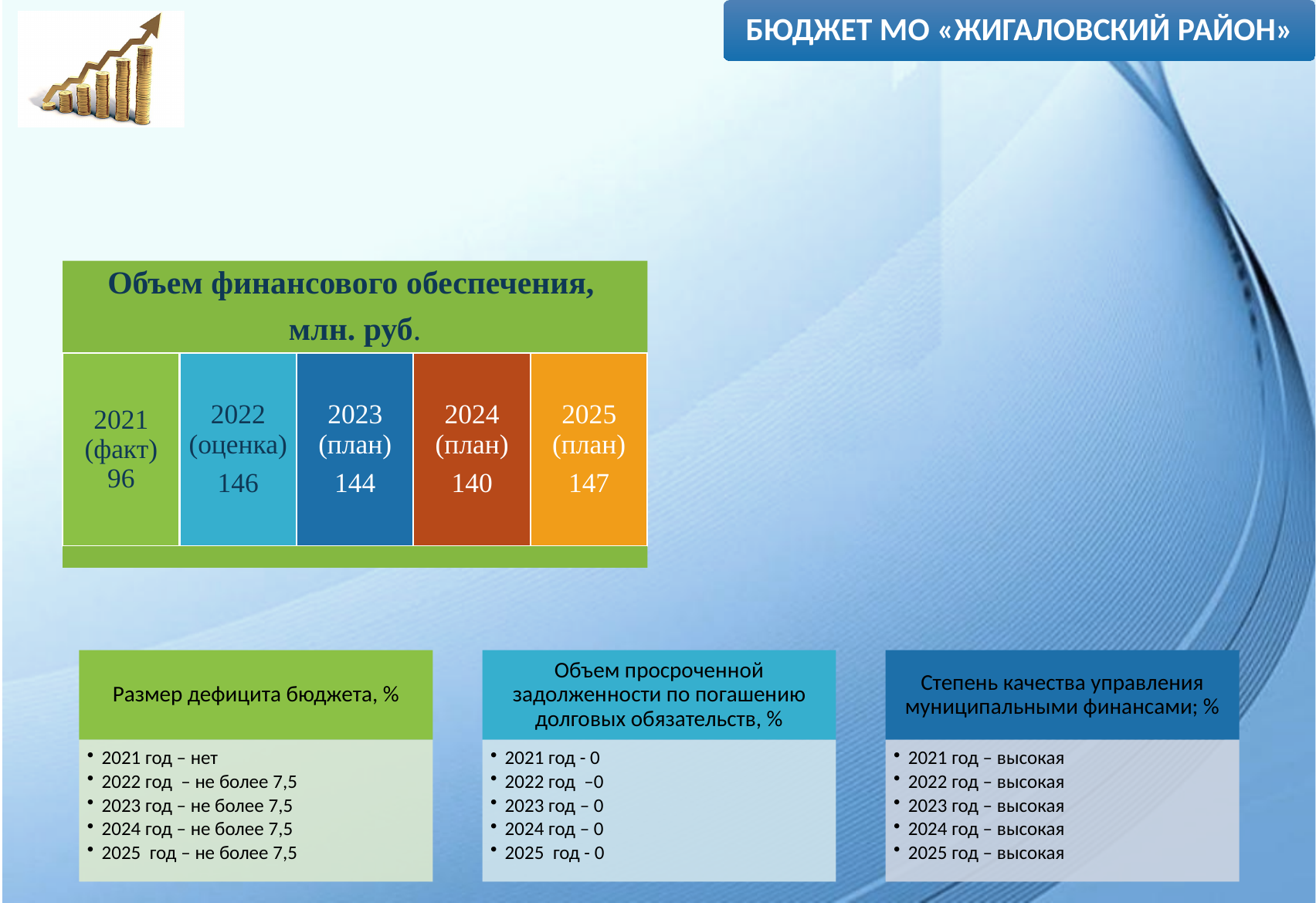
In the 'Объем финансового обеспечения, млн. руб.' chart, which year has the lowest value? 2021 (факт) In the 'Объем финансового обеспечения, млн. руб.' chart, what is the value for 2021 (факт)? 96 In the 'Объем финансового обеспечения, млн. руб.' chart, what is the difference between the 2025 (план) value and the 2024 (план) value? 7 In the 'Объем финансового обеспечения, млн. руб.' chart, which is larger: the value for 2023 (план) or the value for 2024 (план)? 2023 (план) In the 'Объем финансового обеспечения, млн. руб.' chart, does the value rise or fall from 2021 (факт) to 2022 (оценка)? rise What is the title of the chart on the slide? Объем финансового обеспечения, млн. руб. In the 'Объем финансового обеспечения, млн. руб.' chart, what is the value for 2025 (план)? 147 How many years are shown in the 'Объем финансового обеспечения, млн. руб.' chart? 5 In the 'Объем финансового обеспечения, млн. руб.' chart, what is the difference between the 2022 (оценка) value and the 2021 (факт) value? 50 In the 'Объем финансового обеспечения, млн. руб.' chart, what is the value for 2024 (план)? 140 In the 'Объем финансового обеспечения, млн. руб.' chart, which year has the highest value? 2025 (план) In the 'Объем финансового обеспечения, млн. руб.' chart, what is the value for 2022 (оценка)? 146